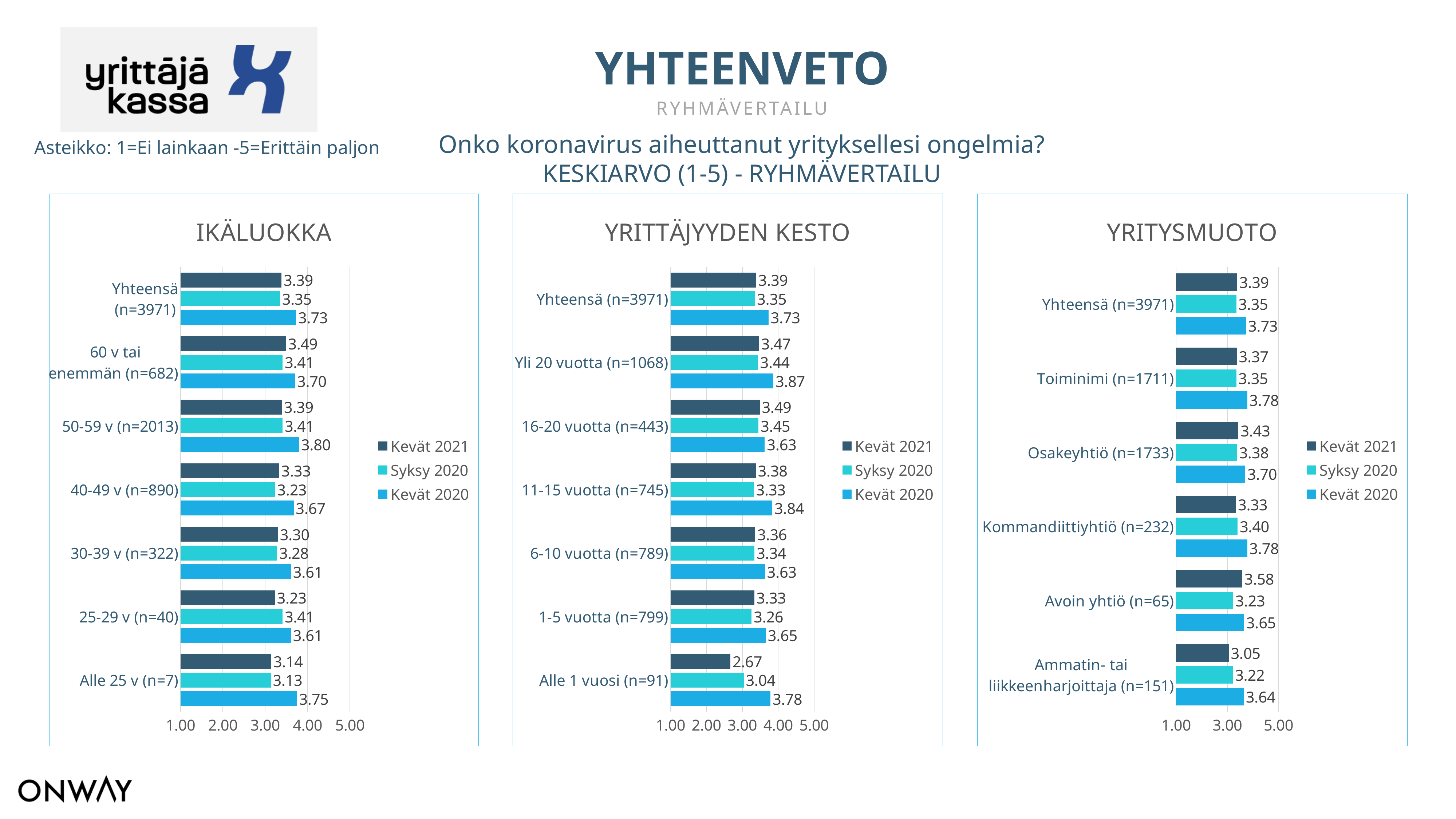
In the IKÄLUOKKA chart, which category has the lowest Syksy 2020 value? Alle 25 v (n=7) In the YRITYSMUOTO chart, what is the Syksy 2020 value for Kommandiittiyhtiö (n=232)? 3.40 In the YRITYSMUOTO chart, which category has the highest Kevät 2021 value? Avoin yhtiö (n=65) In the YRITTÄJYYDEN KESTO chart, what is the Kevät 2021 value for Alle 1 vuosi (n=91)? 2.67 In the IKÄLUOKKA chart, what is the Kevät 2020 value for 50-59 v (n=2013)? 3.80 In the YRITTÄJYYDEN KESTO chart, how many series does the legend list? 3 In the IKÄLUOKKA chart, what is the Kevät 2021 value for 60 v tai enemmän (n=682)? 3.49 In the YRITYSMUOTO chart, how many categories are shown on the vertical axis? 6 In the IKÄLUOKKA chart, what is the difference between the Kevät 2020 and Kevät 2021 values for Alle 25 v (n=7)? 0.61 In the YRITTÄJYYDEN KESTO chart, which category has the highest Kevät 2020 value? Yli 20 vuotta (n=1068) What type of chart is the YRITYSMUOTO chart? Bar chart In the YRITTÄJYYDEN KESTO chart, is the Kevät 2021 value for 16-20 vuotta (n=443) larger or smaller than the Kevät 2021 value for 11-15 vuotta (n=745)? larger